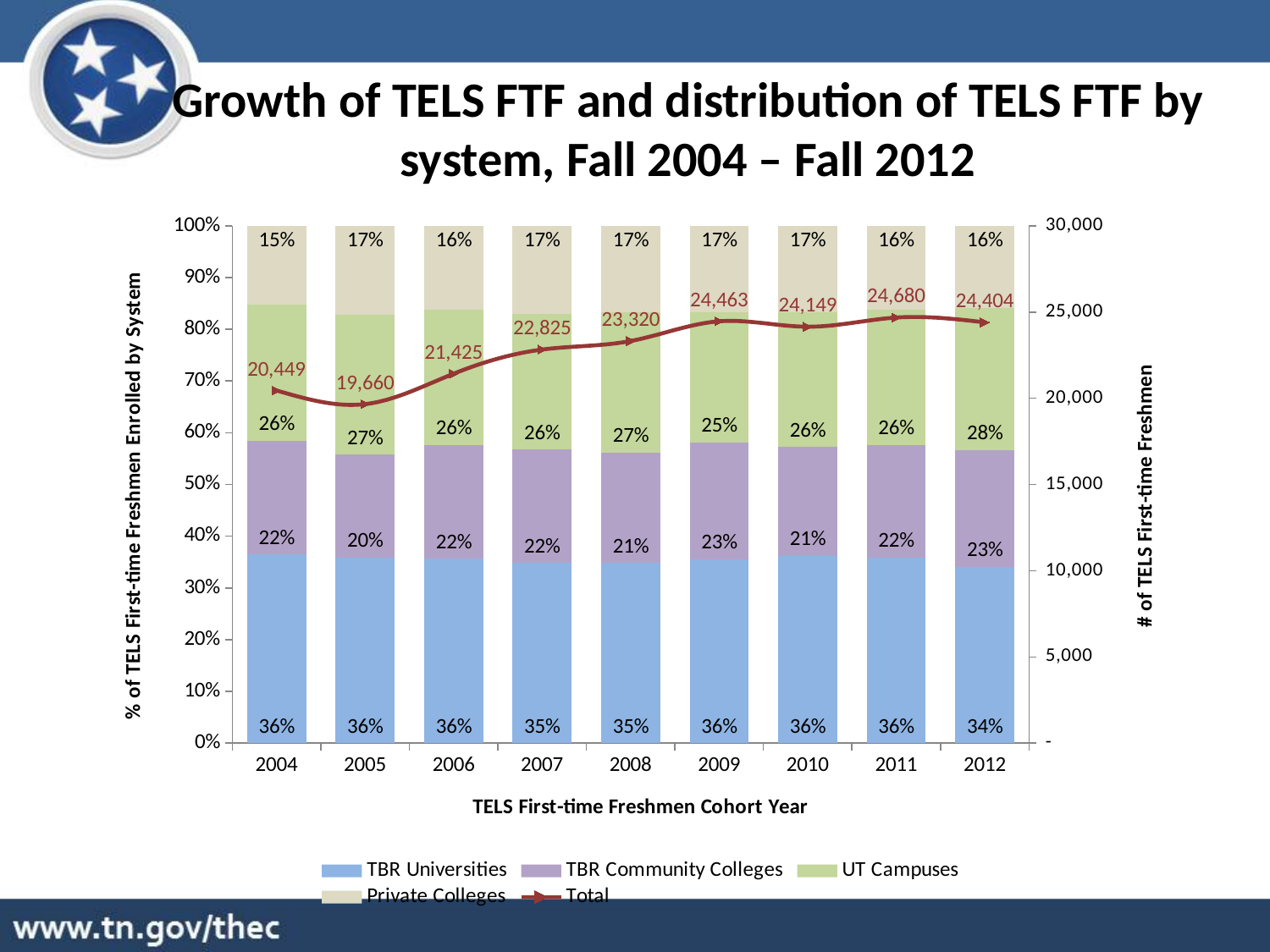
Was the UT Campuses share larger in 2009 or in 2012? 2012 What was the total number of TELS first-time freshmen in 2009? 24,463 In which cohort year was the total number of TELS first-time freshmen lowest? 2005 Did the total number of TELS first-time freshmen rise or fall from 2005 to 2009? Rise What percentage of TELS first-time freshmen were enrolled at TBR Universities in 2012? 34% What percentage of TELS first-time freshmen were enrolled at Private Colleges in 2004? 15% How many cohort years are shown on the x axis? 9 By how much did the total number of TELS first-time freshmen increase from 2004 to 2012? 3,955 What percentage of TELS first-time freshmen were enrolled at TBR Community Colleges in 2005? 20% What kind of chart is shown on the slide? Stacked bar chart with a line How many series does the legend list? 5 In which cohort year was the total number of TELS first-time freshmen highest? 2011